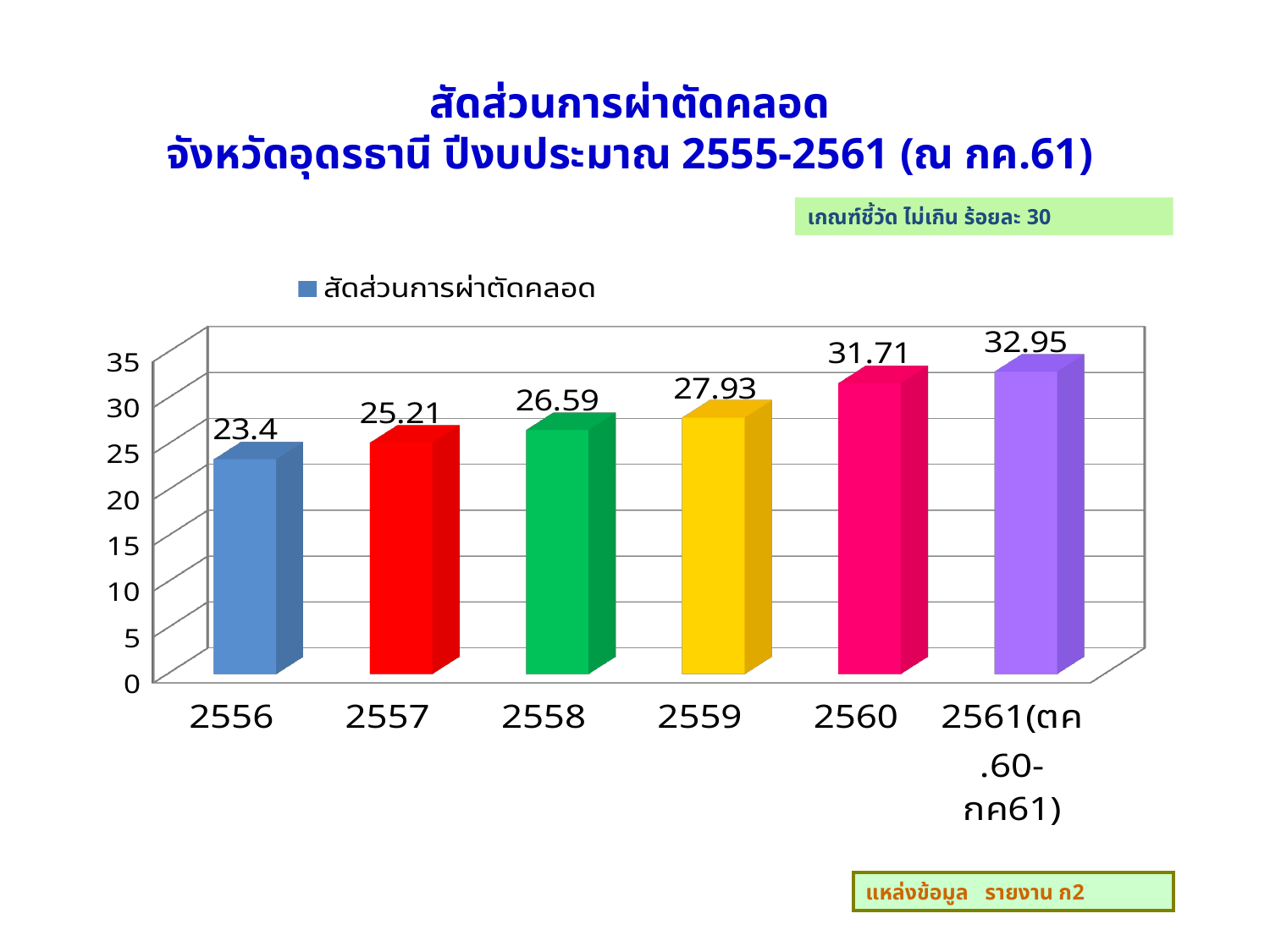
What kind of chart is shown on the slide? bar chart Is the value for 2560 greater or less than 30? greater Which year has the lowest value? 2556 What is the difference between the values for 2558 and 2557? 1.38 Do the values rise or fall from 2556 to 2561? rise What is the difference between the values for 2560 and 2559? 3.78 How many bars are shown in the chart? 6 What is the value for 2560? 31.71 Which year has the highest value? 2561(ตค.60-กค61) What is the value for 2556? 23.4 Which is larger, the value for 2557 or the value for 2558? 2558 What is the value for 2559? 27.93